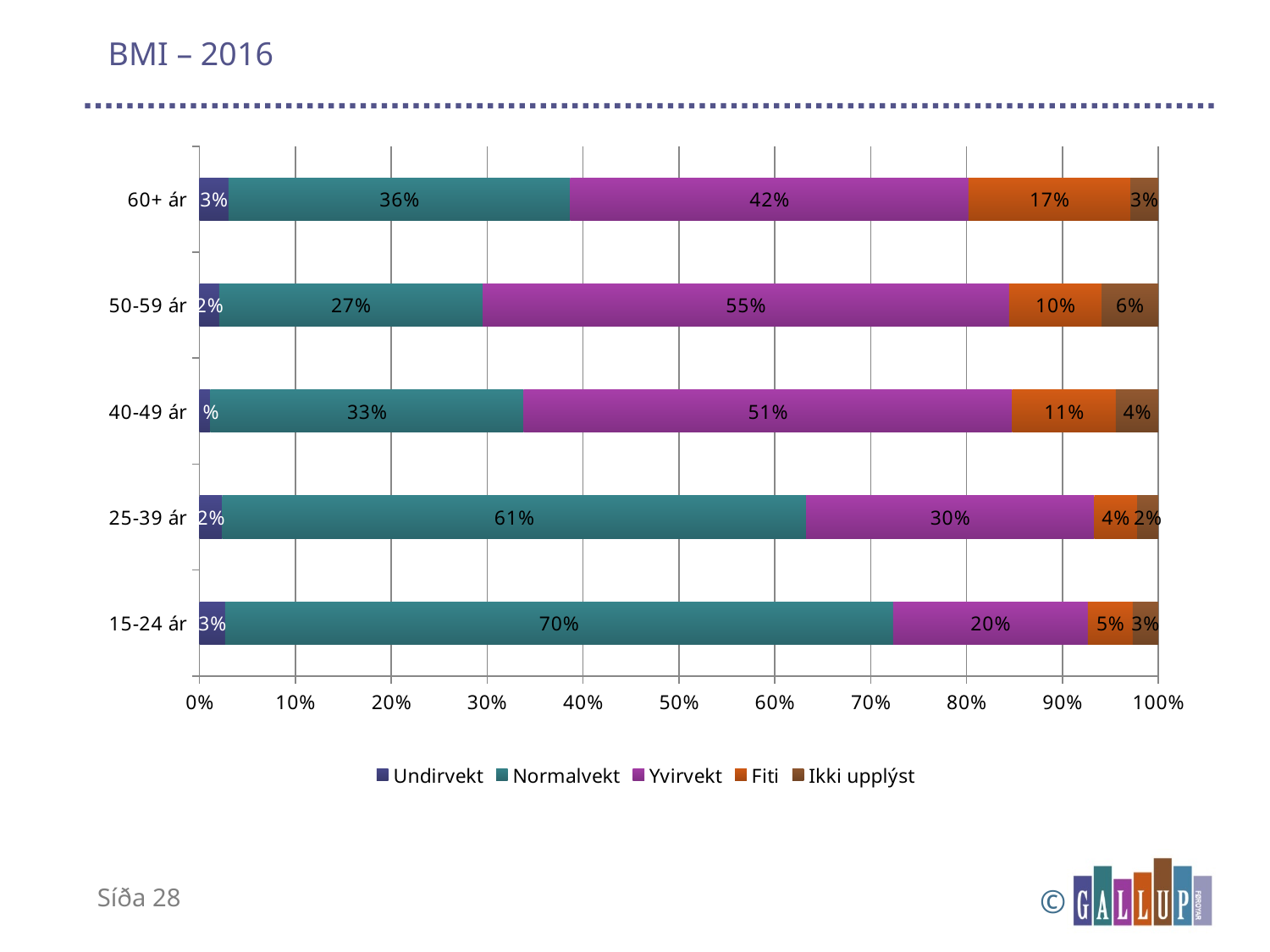
How many age groups are shown on the chart? 5 What is the Normalvekt value for the 15-24 ár group? 70% What kind of chart is shown on the slide? Stacked bar chart What is the Fiti value for the 60+ ár group? 17% What is the title of the chart? BMI – 2016 How many series does the legend list? 5 Which age group has the highest Normalvekt share? 15-24 ár What is the Yvirvekt value for the 50-59 ár group? 55% Which age group has the lowest Yvirvekt share? 15-24 ár What is the Ikki upplýst value for the 50-59 ár group? 6% What is the difference between the Normalvekt values for 15-24 ár and 60+ ár? 34 percentage points Which group has a larger Yvirvekt share, 40-49 ár or 60+ ár? 40-49 ár